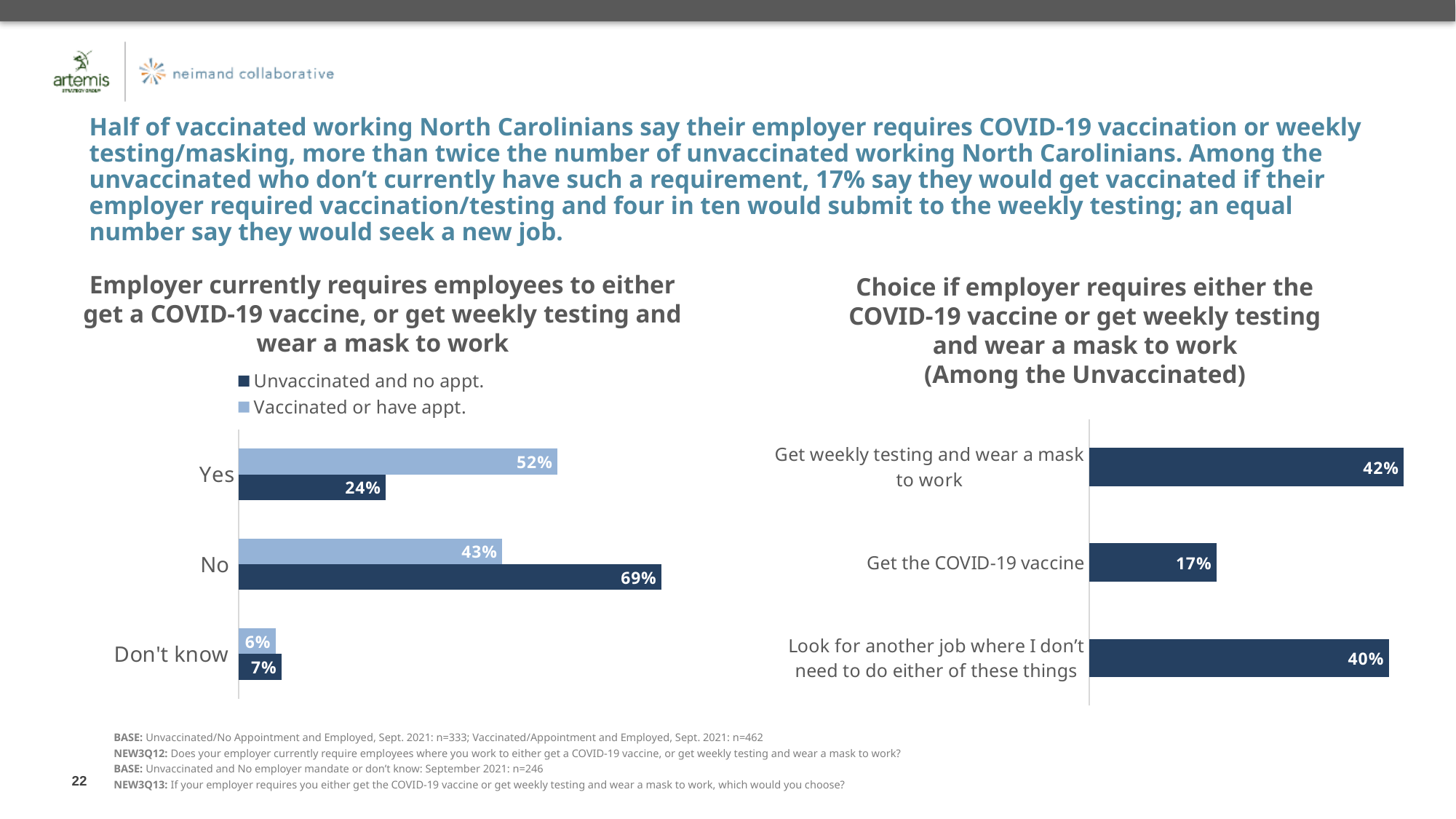
In the left chart, what is the value for 'Don't know' among the Vaccinated or have appt. group? 6% In the left chart, what is the value for 'No' among the Unvaccinated and no appt. group? 69% In the left chart (Employer currently requires employees to either get a COVID-19 vaccine, or get weekly testing and wear a mask to work), what is the value for 'Yes' among the Vaccinated or have appt. group? 52% In the right chart, which option has the lowest value? Get the COVID-19 vaccine In the left chart, what is the difference between the Vaccinated or have appt. and Unvaccinated and no appt. values for 'Yes'? 28 percentage points What type of chart is the right chart? Bar chart How many series does the legend of the left chart list? 2 How many categories are shown in the left chart? 3 In the right chart (Choice if employer requires either the COVID-19 vaccine or get weekly testing and wear a mask to work), what is the value for 'Get the COVID-19 vaccine'? 17% In the right chart, what is the difference between 'Get weekly testing and wear a mask to work' and 'Look for another job where I don't need to do either of these things'? 2 percentage points In the left chart, which group has the larger value for 'No'? Unvaccinated and no appt. In the right chart, which option has the highest value? Get weekly testing and wear a mask to work